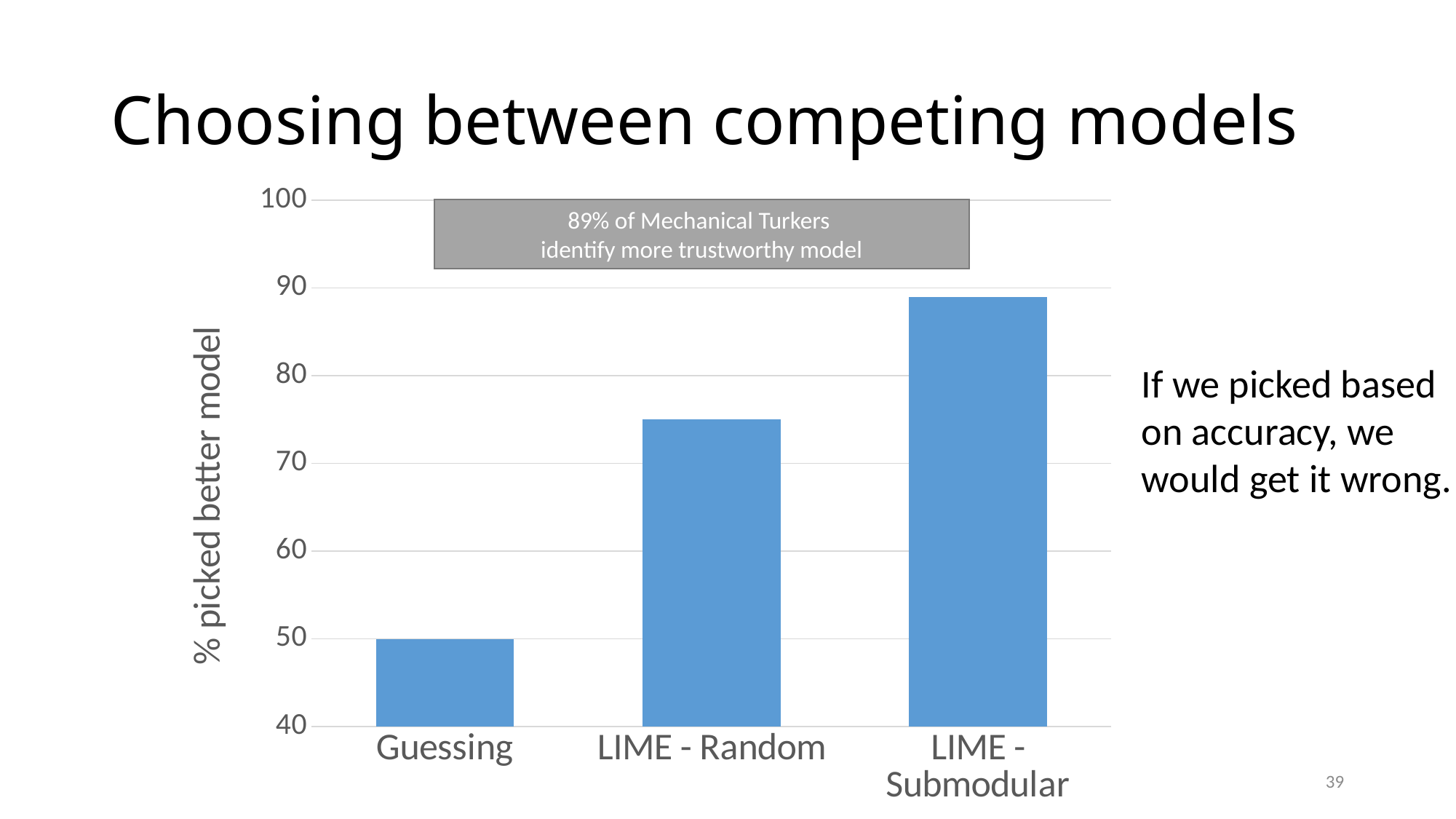
What is the label on the y axis of the chart? % picked better model Is the value for LIME - Random greater or less than 70? greater According to the annotation on the chart, what percentage of Mechanical Turkers identify the more trustworthy model? 89% Which category has the highest value in the chart? LIME - Submodular Is the value for LIME - Random greater or less than 80? less Which is larger, the value for LIME - Random or the value for Guessing? LIME - Random Is the value for LIME - Submodular greater or less than 90? less Which category has the lowest value in the chart? Guessing What is the value for Guessing? 50 What kind of chart is shown on the slide? bar chart Do the values rise or fall from left to right across the categories? rise How many categories are shown on the x axis of the chart? 3